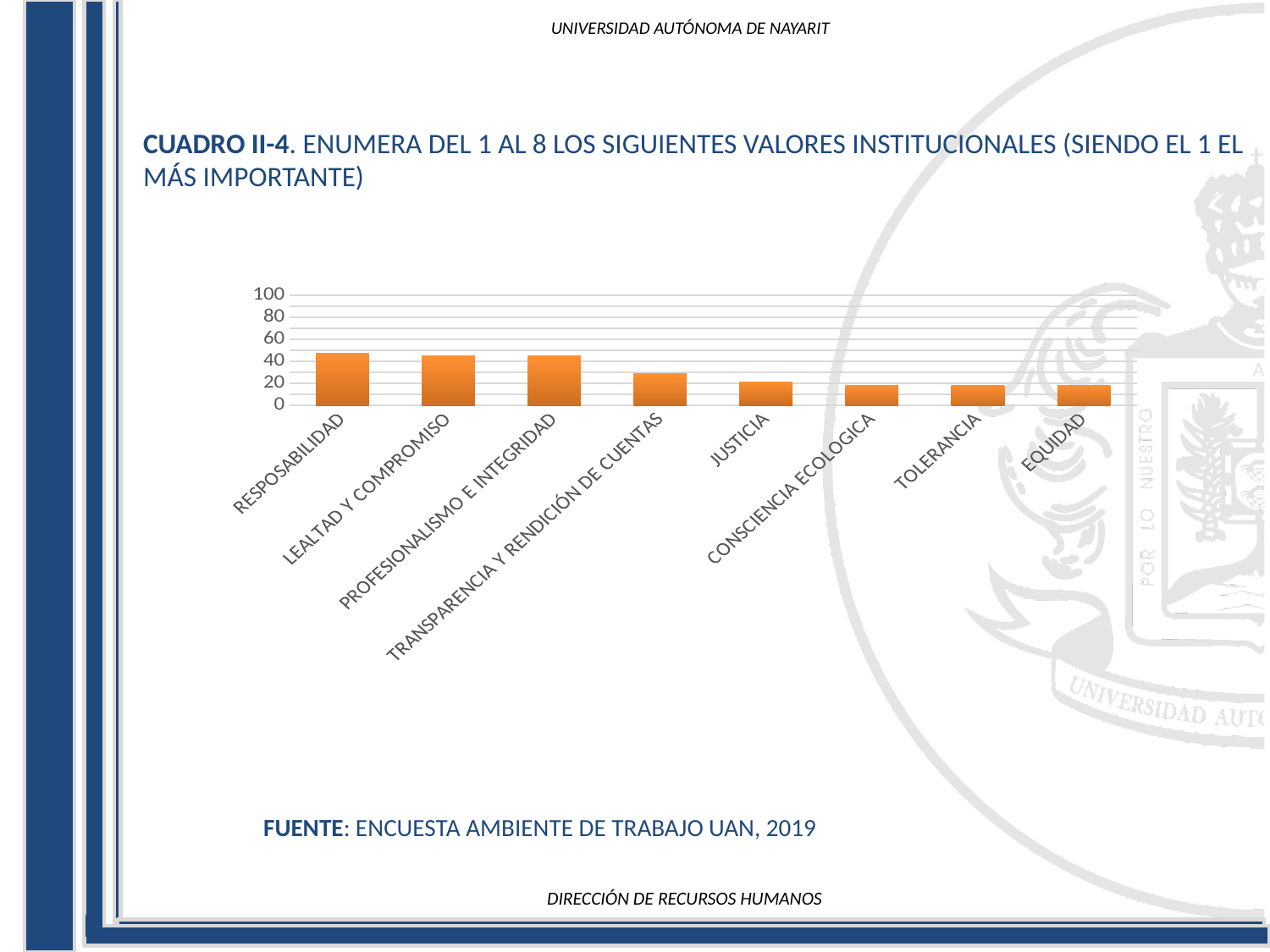
What kind of chart is shown on the slide? bar chart Which has a larger value, TRANSPARENCIA Y RENDICIÓN DE CUENTAS or TOLERANCIA? TRANSPARENCIA Y RENDICIÓN DE CUENTAS Do the bar values generally rise or fall from left to right along the x axis? fall Is the value for TRANSPARENCIA Y RENDICIÓN DE CUENTAS greater or less than 20? greater Is the value for LEALTAD Y COMPROMISO greater or less than 60? less Is the value for JUSTICIA greater or less than 40? less How many categories (institutional values) are plotted on the chart? 8 Which has a larger value, PROFESIONALISMO E INTEGRIDAD or CONSCIENCIA ECOLOGICA? PROFESIONALISMO E INTEGRIDAD What colour are the bars in the chart? orange Which has a larger value, RESPOSABILIDAD or JUSTICIA? RESPOSABILIDAD